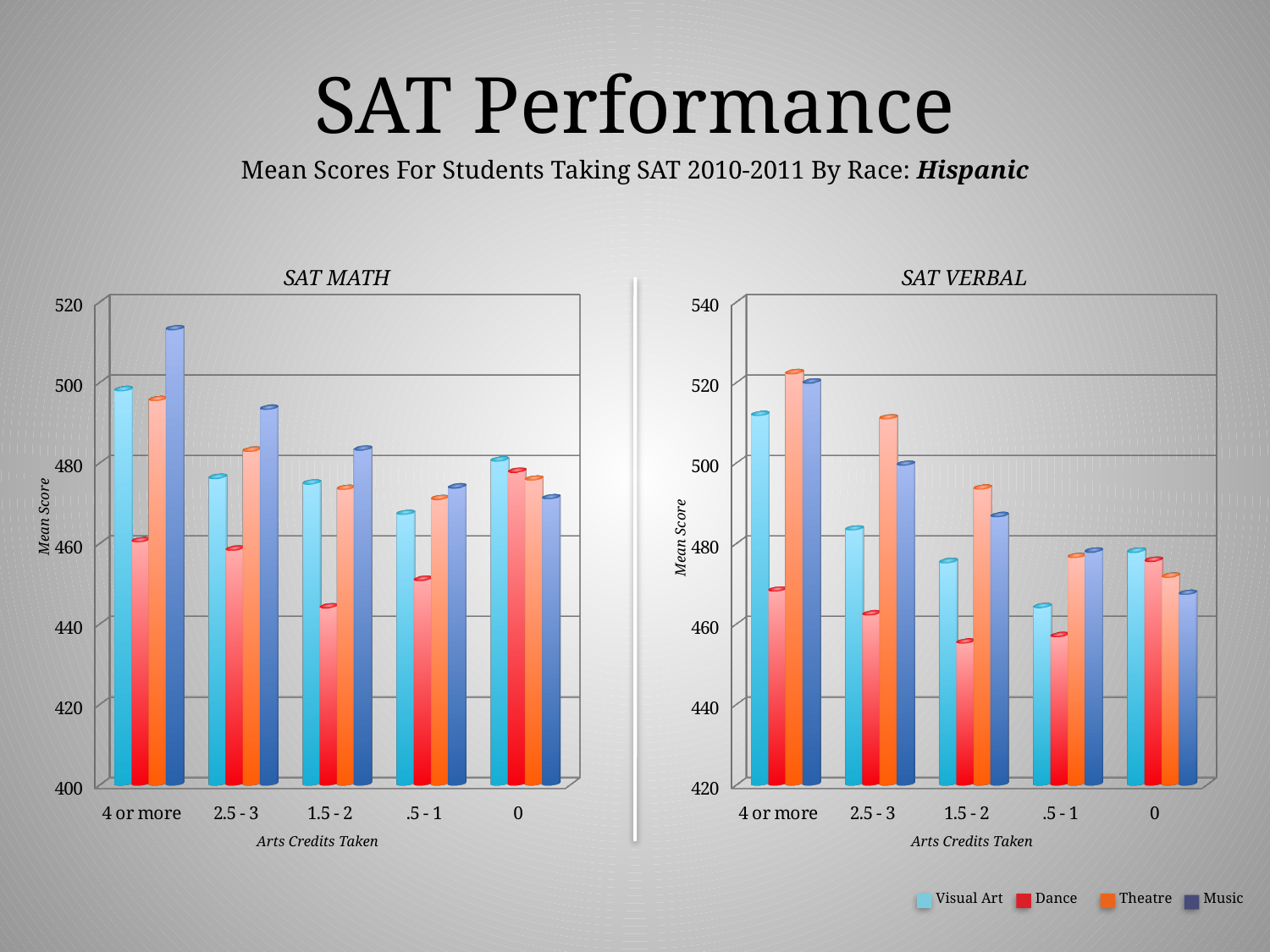
In the SAT VERBAL chart, which series has the lowest bar in the '2.5 - 3' category? Dance In the SAT VERBAL chart, is the value for Dance in the '4 or more' category greater or less than 480? less In the SAT MATH chart, how many arts-credit categories are shown on the x axis? 5 What kind of chart is the SAT MATH chart? bar chart In the SAT VERBAL chart, is the value for Theatre in the '2.5 - 3' category greater or less than 500? greater How many series does the legend list? 4 In the SAT MATH chart, is the value for Music in the '4 or more' category greater or less than 500? greater What is the x-axis title of the SAT VERBAL chart? Arts Credits Taken In the SAT VERBAL chart, which is larger in the '2.5 - 3' category, Theatre or Visual Art? Theatre In the SAT MATH chart, which series has the lowest bar in the '1.5 - 2' category? Dance In the SAT MATH chart, which series has the highest bar in the '4 or more' category? Music